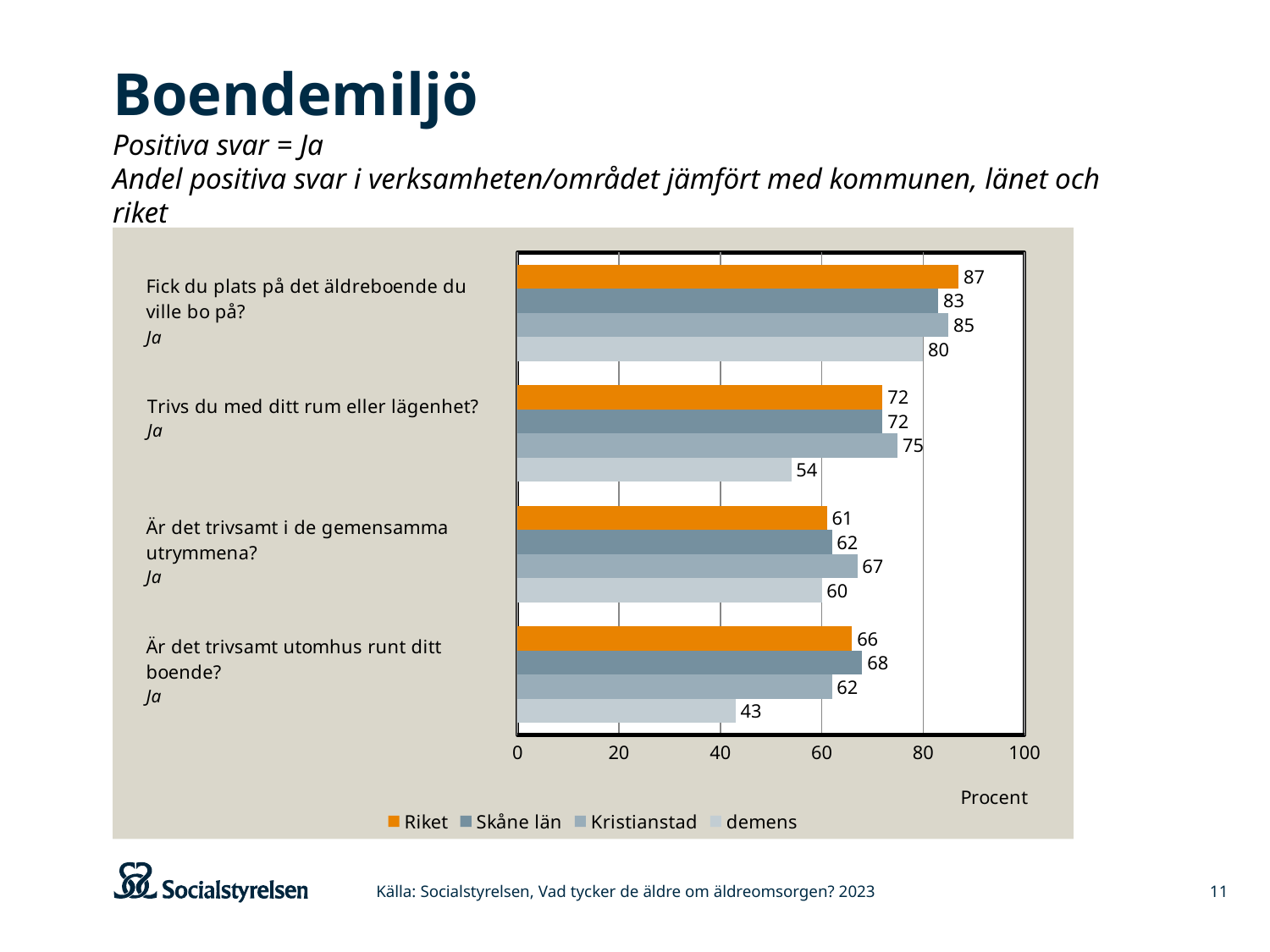
How many series does the legend list? 4 Which is larger for "Är det trivsamt utomhus runt ditt boende?": the value for Riket or the value for Kristianstad? Riket What is the value for Riket for "Fick du plats på det äldreboende du ville bo på?"? 87 How many question categories are shown on the chart? 4 What is the value for Skåne län for "Är det trivsamt utomhus runt ditt boende?"? 68 What is the value for demens for "Trivs du med ditt rum eller lägenhet?"? 54 What kind of chart is shown on the slide? bar chart Which series has the lowest value for "Är det trivsamt utomhus runt ditt boende?"? demens Is the value for demens for "Är det trivsamt utomhus runt ditt boende?" greater or less than 60? less What is the value for Kristianstad for "Är det trivsamt i de gemensamma utrymmena?"? 67 Which series has the highest value for "Fick du plats på det äldreboende du ville bo på?"? Riket What is the difference between the Kristianstad and demens values for "Trivs du med ditt rum eller lägenhet?"? 21